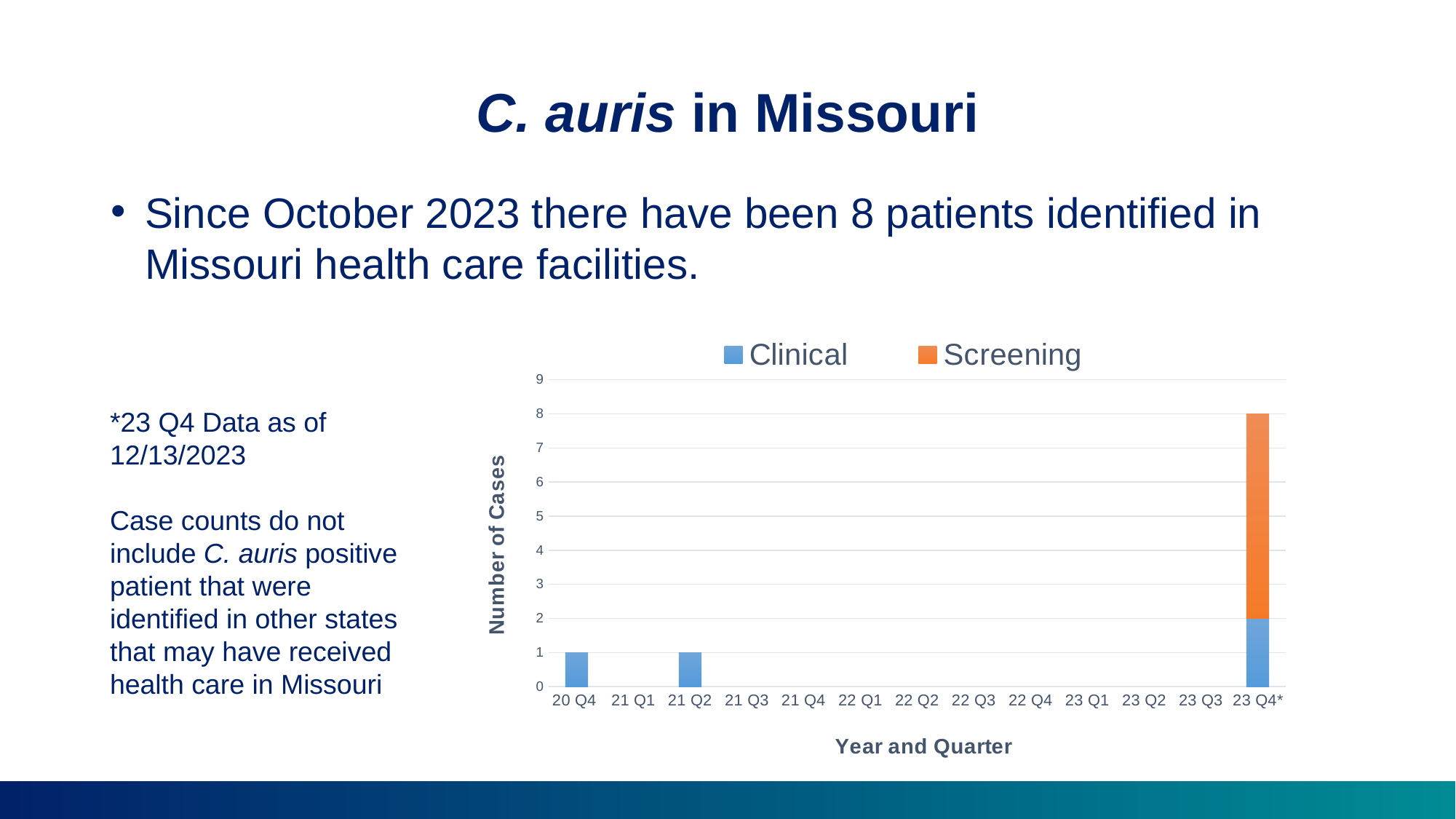
Which quarter has the highest total number of cases in the chart? 23 Q4* What is the difference between the total cases for 23 Q4* and the Clinical cases for 23 Q4*? 6 What is the total number of cases for 23 Q4* in the chart? 8 What is the label of the y axis of the chart? Number of Cases What is the number of Clinical cases for 20 Q4? 1 What kind of chart is shown on the slide? Stacked bar chart What is the number of Clinical cases for 23 Q4*? 2 How many series does the chart legend list? 2 What are the two series named in the chart legend? Clinical and Screening What is the number of Clinical cases for 21 Q2? 1 How many year-and-quarter categories are shown on the x axis of the chart? 13 Which is larger, the total cases for 23 Q4* or the total cases for 21 Q2? 23 Q4*